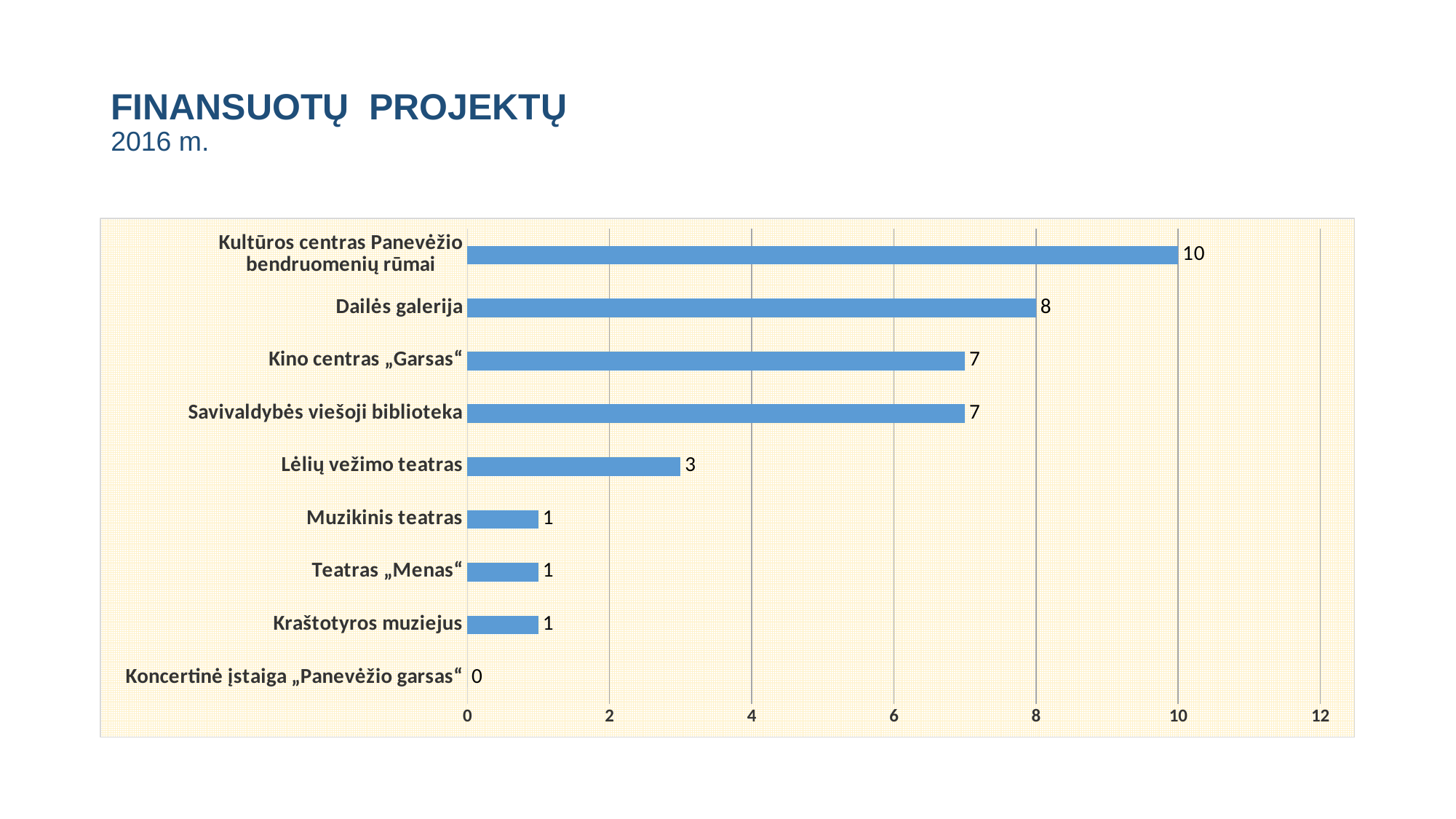
Is the value for Savivaldybės viešoji biblioteka greater or less than 4? greater What is the maximum value shown on the horizontal axis? 12 What kind of chart is shown on the slide? bar chart How many categories are shown in the chart? 9 Which category has the highest value? Kultūros centras Panevėžio bendruomenių rūmai What is the value for Dailės galerija? 8 What is the difference between the values for Dailės galerija and Lėlių vežimo teatras? 5 What is the value for Koncertinė įstaiga „Panevėžio garsas“? 0 Which category has the lowest value? Koncertinė įstaiga „Panevėžio garsas“ Which is larger, the value for Kino centras „Garsas“ or the value for Muzikinis teatras? Kino centras „Garsas“ What is the value for Lėlių vežimo teatras? 3 What is the value for Kultūros centras Panevėžio bendruomenių rūmai? 10